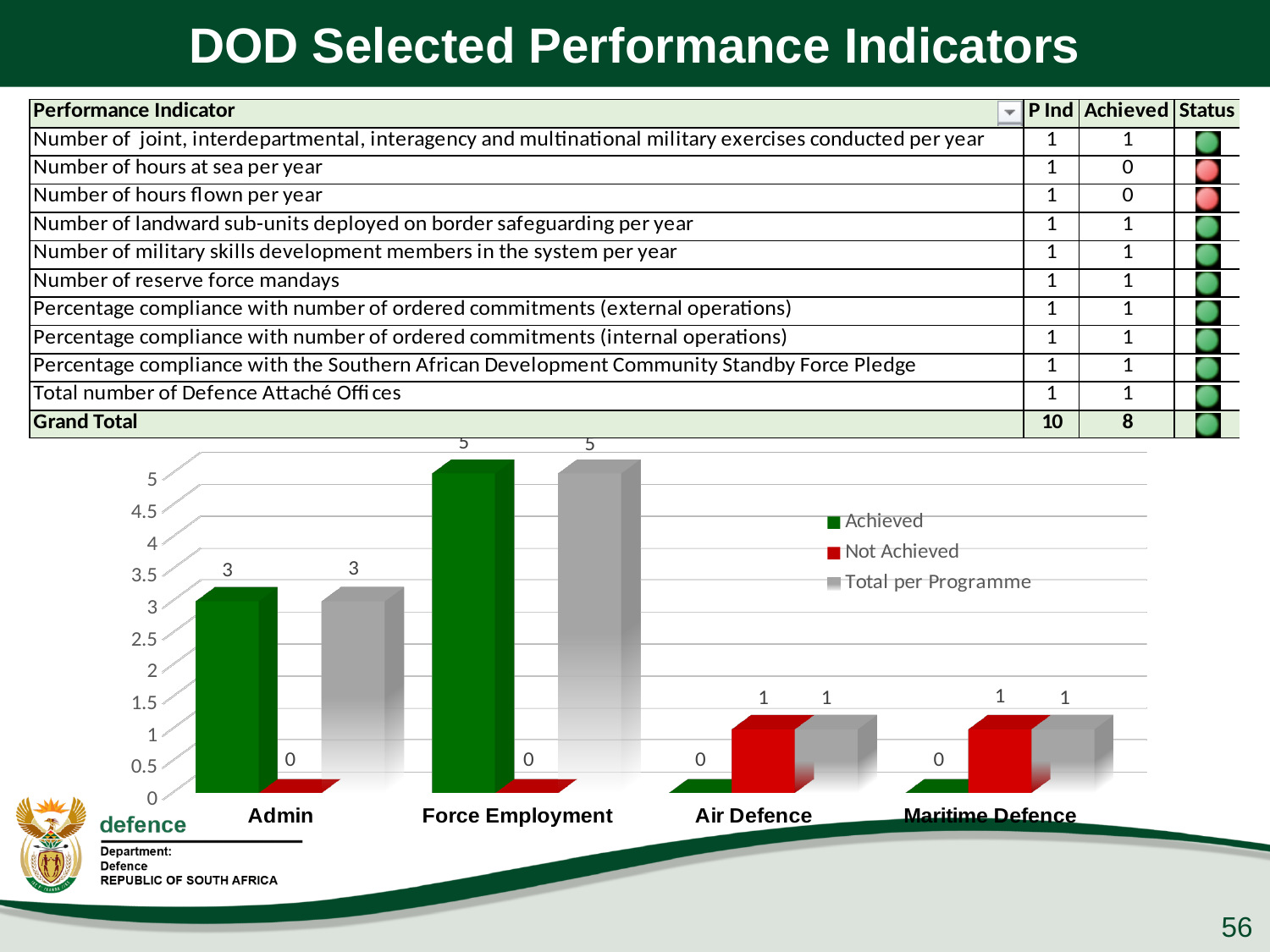
What is the Achieved value for Force Employment in the chart? 5 Which programme has the highest Achieved value in the chart? Force Employment What is the Not Achieved value for Admin in the chart? 0 What kind of chart is shown on the slide? bar chart What is the Total per Programme value for Maritime Defence in the chart? 1 Which colour represents the Not Achieved series in the chart? red What is the difference between the Achieved values for Force Employment and Admin? 2 Which is larger in the chart: the Total per Programme for Admin or for Air Defence? Admin What is the Not Achieved value for Air Defence in the chart? 1 How many programme categories are shown on the x axis of the chart? 4 How many series does the chart legend list? 3 What is the Achieved value for Admin in the chart? 3